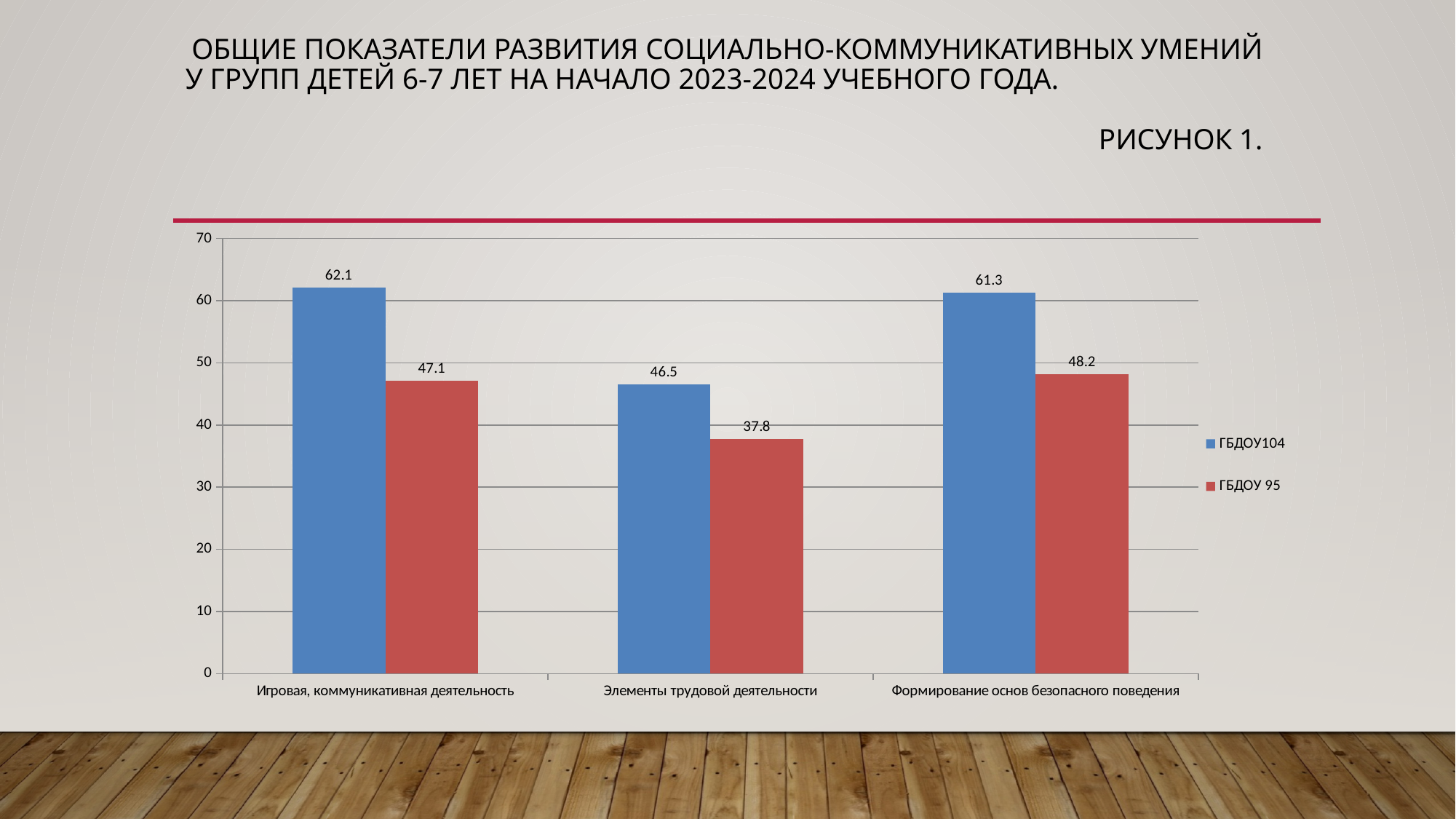
How many categories are shown on the x axis of the chart? 3 What is the difference between the ГБДОУ104 and ГБДОУ 95 values in the category Элементы трудовой деятельности? 8.7 What is the value for ГБДОУ 95 in the category Формирование основ безопасного поведения? 48.2 What kind of chart is shown on the slide? bar chart How many series does the legend of the chart list? 2 Which category has the highest value for ГБДОУ104? Игровая, коммуникативная деятельность Which is larger in the category Формирование основ безопасного поведения: the value for ГБДОУ104 or for ГБДОУ 95? ГБДОУ104 Is the value for ГБДОУ104 in the category Элементы трудовой деятельности greater or less than 50? less What is the value for ГБДОУ 95 in the category Элементы трудовой деятельности? 37.8 What is the difference between the ГБДОУ104 and ГБДОУ 95 values in the category Игровая, коммуникативная деятельность? 15 Which category has the lowest value for ГБДОУ 95? Элементы трудовой деятельности What is the value for ГБДОУ104 in the category Игровая, коммуникативная деятельность? 62.1